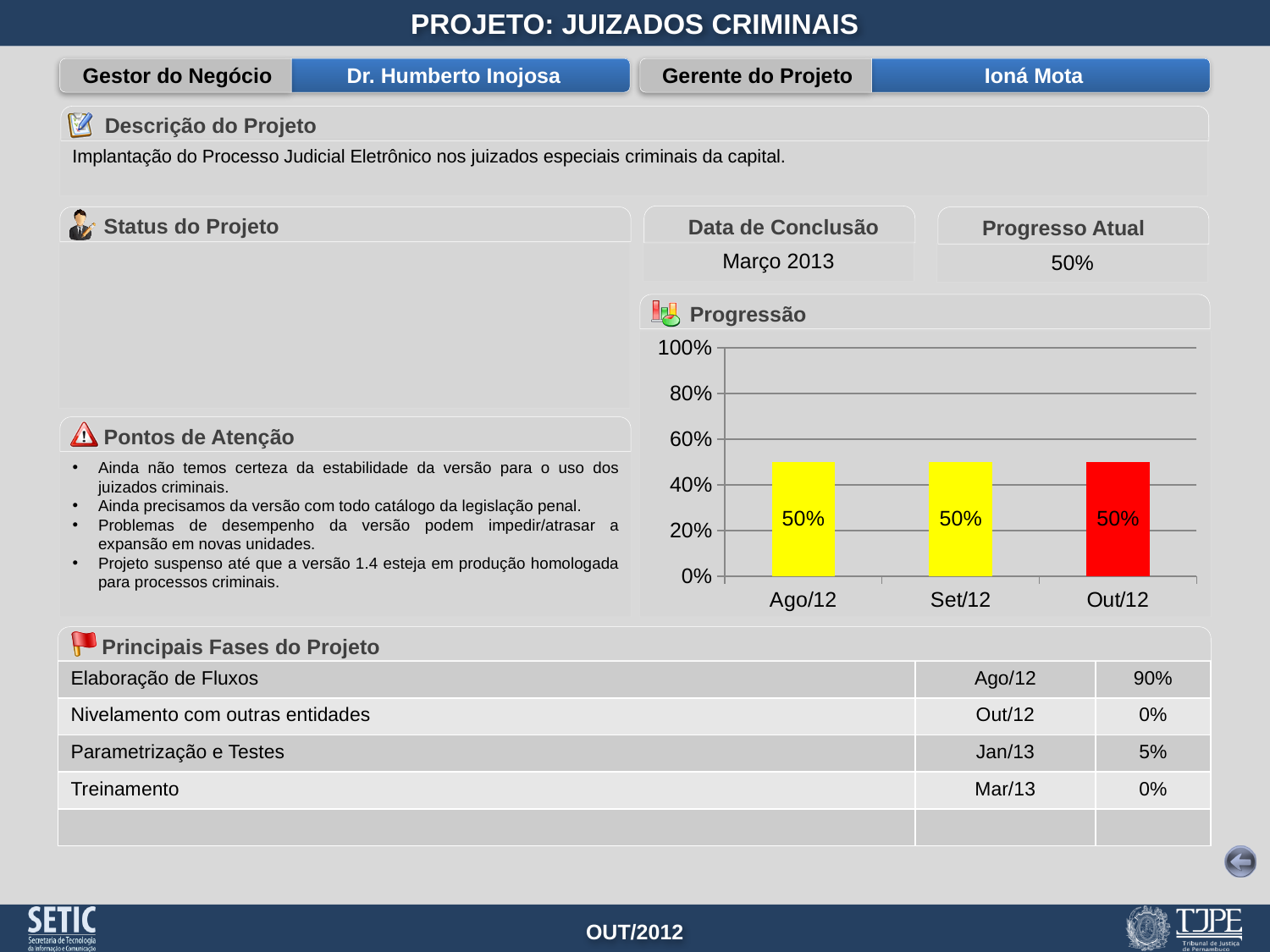
What is the title of the bar chart on the slide? Progressão What is the value for Ago/12 in the Progressão chart? 50% What colour is the Out/12 bar in the Progressão chart? red What kind of chart is the Progressão chart? bar chart What is the value for Out/12 in the Progressão chart? 50% What is the highest value shown on the y axis of the Progressão chart? 100% Is the value for Set/12 in the Progressão chart greater or less than 80%? less What is the value for Set/12 in the Progressão chart? 50% What is the difference between the values for Ago/12 and Out/12 in the Progressão chart? 0% How many bars are plotted in the Progressão chart? 3 Is the value for Out/12 in the Progressão chart greater or less than 20%? greater Do the values in the Progressão chart rise, fall or stay flat from Ago/12 to Out/12? stay flat